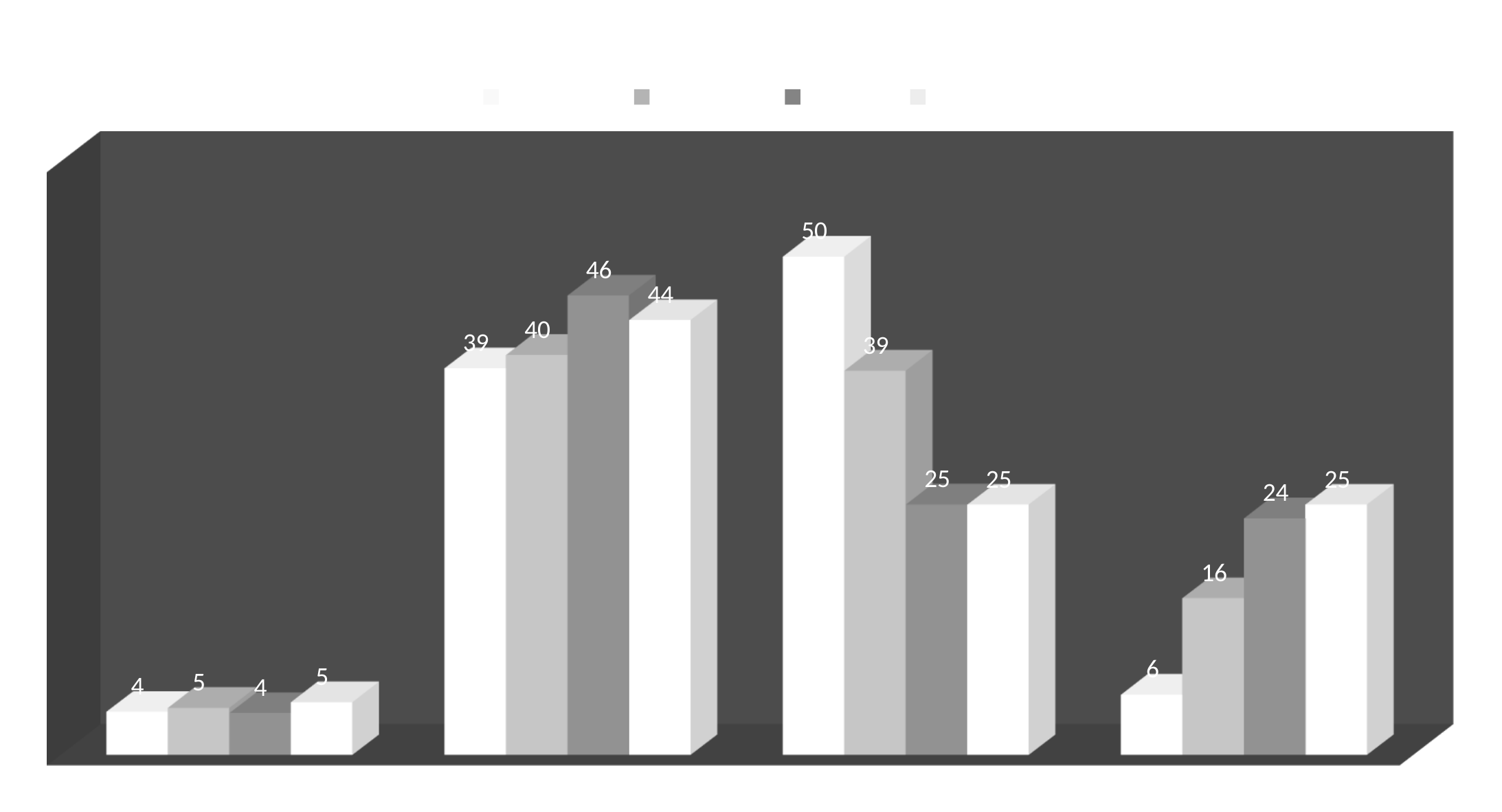
What kind of chart is shown on the slide? bar chart What is the lowest value labelled on the chart? 4 What is the value of the third bar in the second group from the left? 46 What is the value of the first (leftmost) bar in the fourth group from the left? 6 In the third group from the left, what is the difference between the first bar (50) and the second bar (39)? 11 Within the fourth group from the left, do the bar values rise or fall from left to right? rise What is the highest value labelled on the chart? 50 In the fourth group from the left, which is larger: the second bar or the third bar? the third bar What is the value of the fourth bar in the second group from the left? 44 In the second group from the left, what is the difference between the third bar (46) and the first bar (39)? 7 How many series does the legend list? 4 How many groups of bars are plotted along the x axis? 4